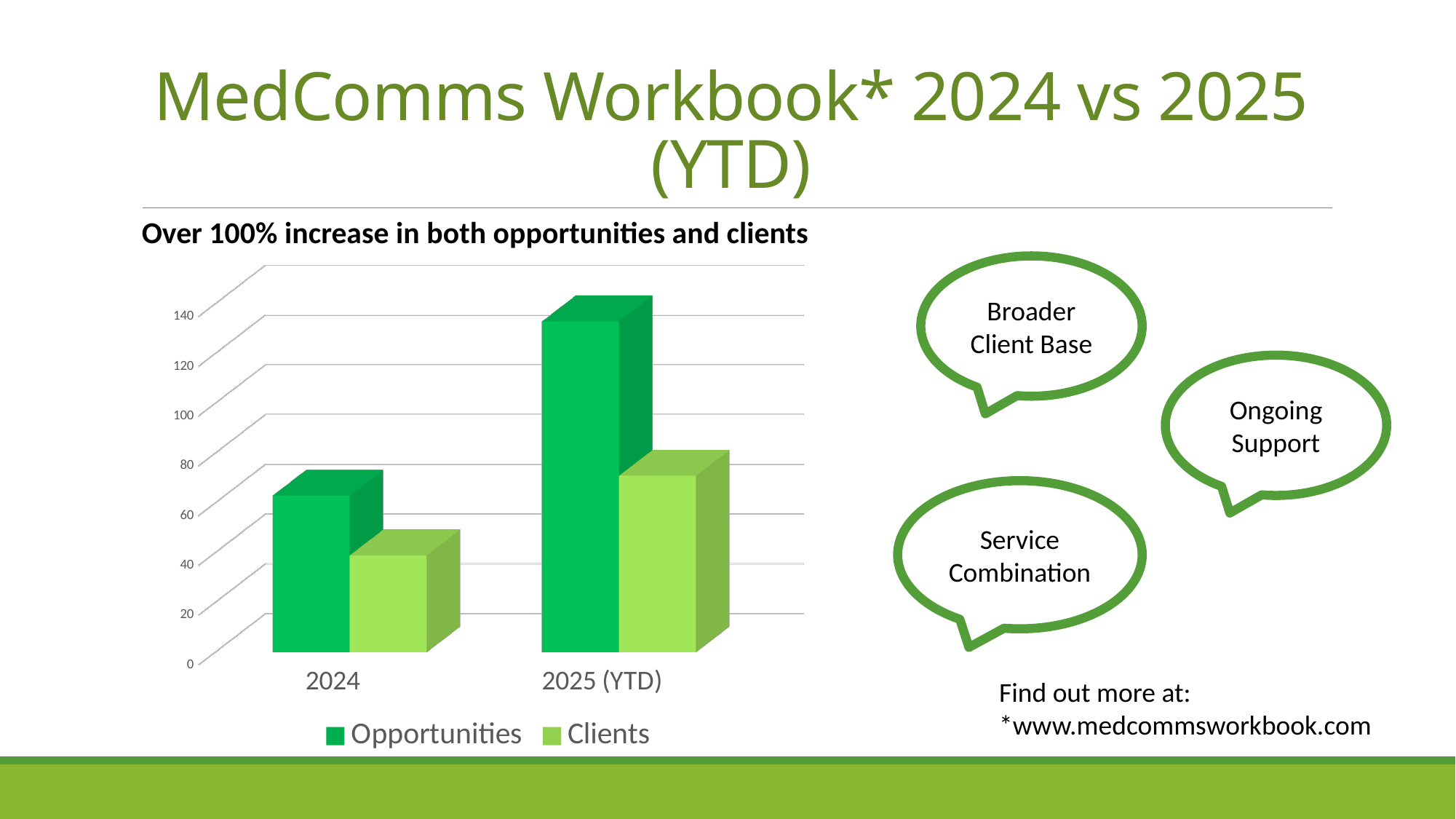
Which category has the lowest Clients value? 2024 What is the heading text shown directly above the chart? Over 100% increase in both opportunities and clients How many categories are shown on the x axis of the chart? 2 What kind of chart is shown on the slide? Bar chart Is the Opportunities value for 2025 (YTD) greater or less than 120? greater Do the Opportunities values rise or fall from 2024 to 2025 (YTD)? Rise Which category has the highest Opportunities value? 2025 (YTD) Which is larger in 2025 (YTD): Opportunities or Clients? Opportunities Is the Clients value for 2025 (YTD) greater or less than 60? greater What are the two series named in the chart legend? Opportunities and Clients Is the Clients value for 2024 greater or less than 80? less How many series does the chart legend list? 2